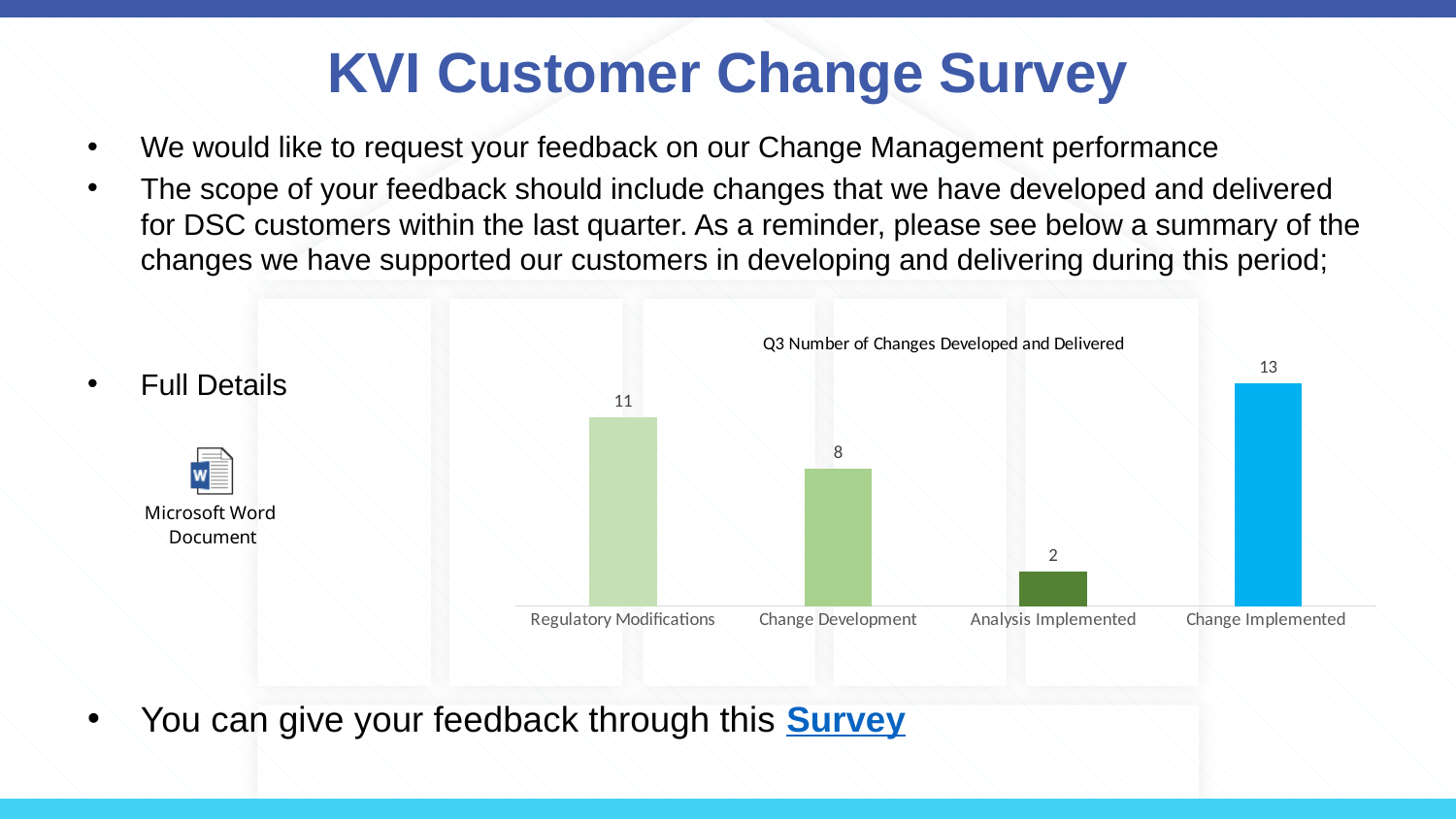
What is the value for Change Implemented? 13 Which is larger, the value for Regulatory Modifications or the value for Change Development? Regulatory Modifications What is the difference between the values for Change Development and Analysis Implemented? 6 Which category has the lowest value? Analysis Implemented What kind of chart is shown on the slide? Bar chart What is the value for Regulatory Modifications? 11 Which category has the highest value? Change Implemented What is the value for Analysis Implemented? 2 What is the difference between the values for Change Implemented and Regulatory Modifications? 2 What is the value for Change Development? 8 How many categories are shown in the chart? 4 What is the title of the chart? Q3 Number of Changes Developed and Delivered